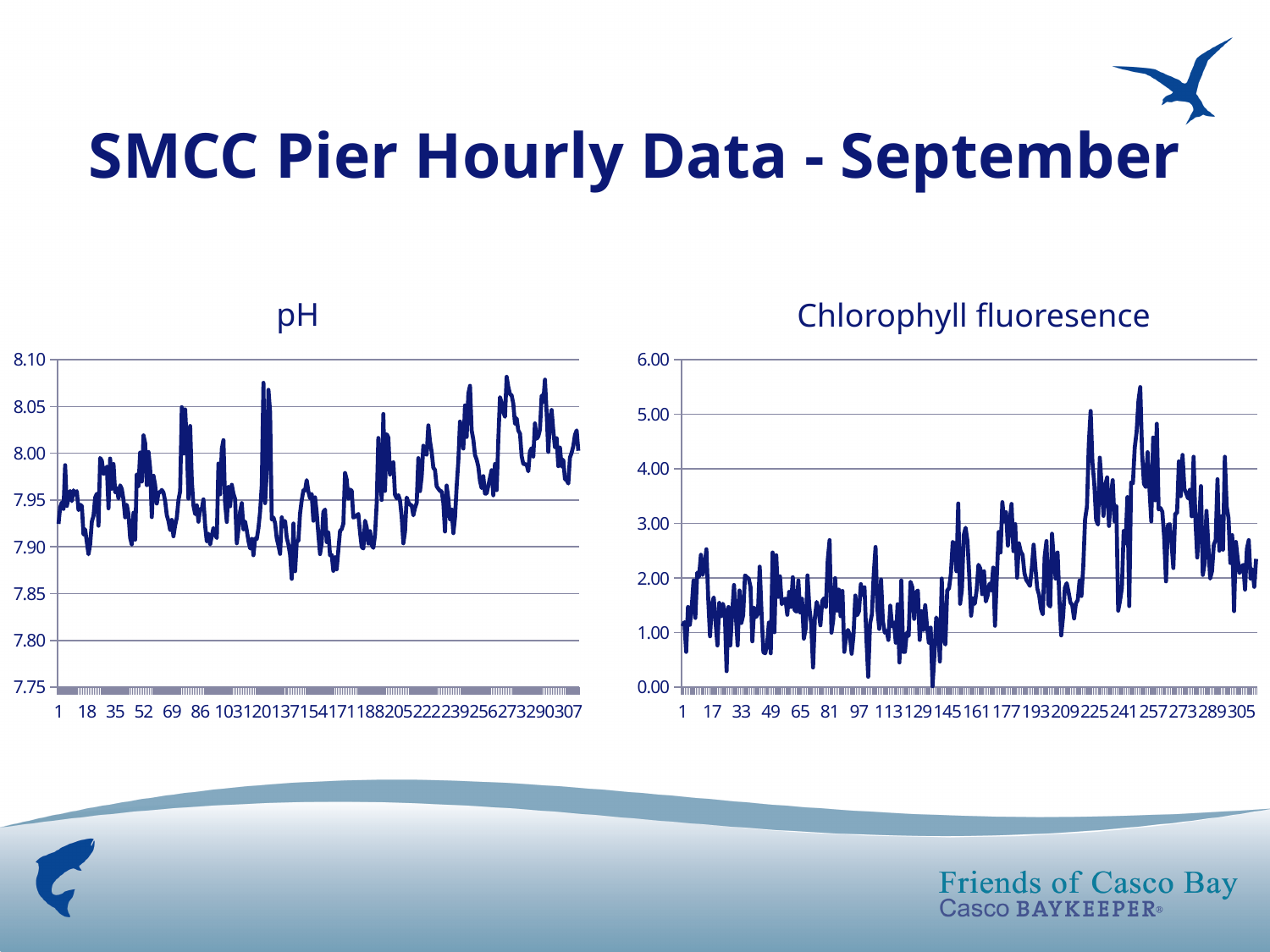
In the Chlorophyll fluoresence chart, is the highest peak greater or less than 5.00? greater In the Chlorophyll fluoresence chart, is the lowest value greater or less than 1.00? less What is the title of the chart on the left? pH In the Chlorophyll fluoresence chart, do the values generally rise or fall along the x axis? rise In the pH chart, is the lowest value greater or less than 7.90? less What kind of chart is the Chlorophyll fluoresence chart on the right? line chart What is the title of the chart on the right? Chlorophyll fluoresence What kind of chart is the pH chart on the left? line chart